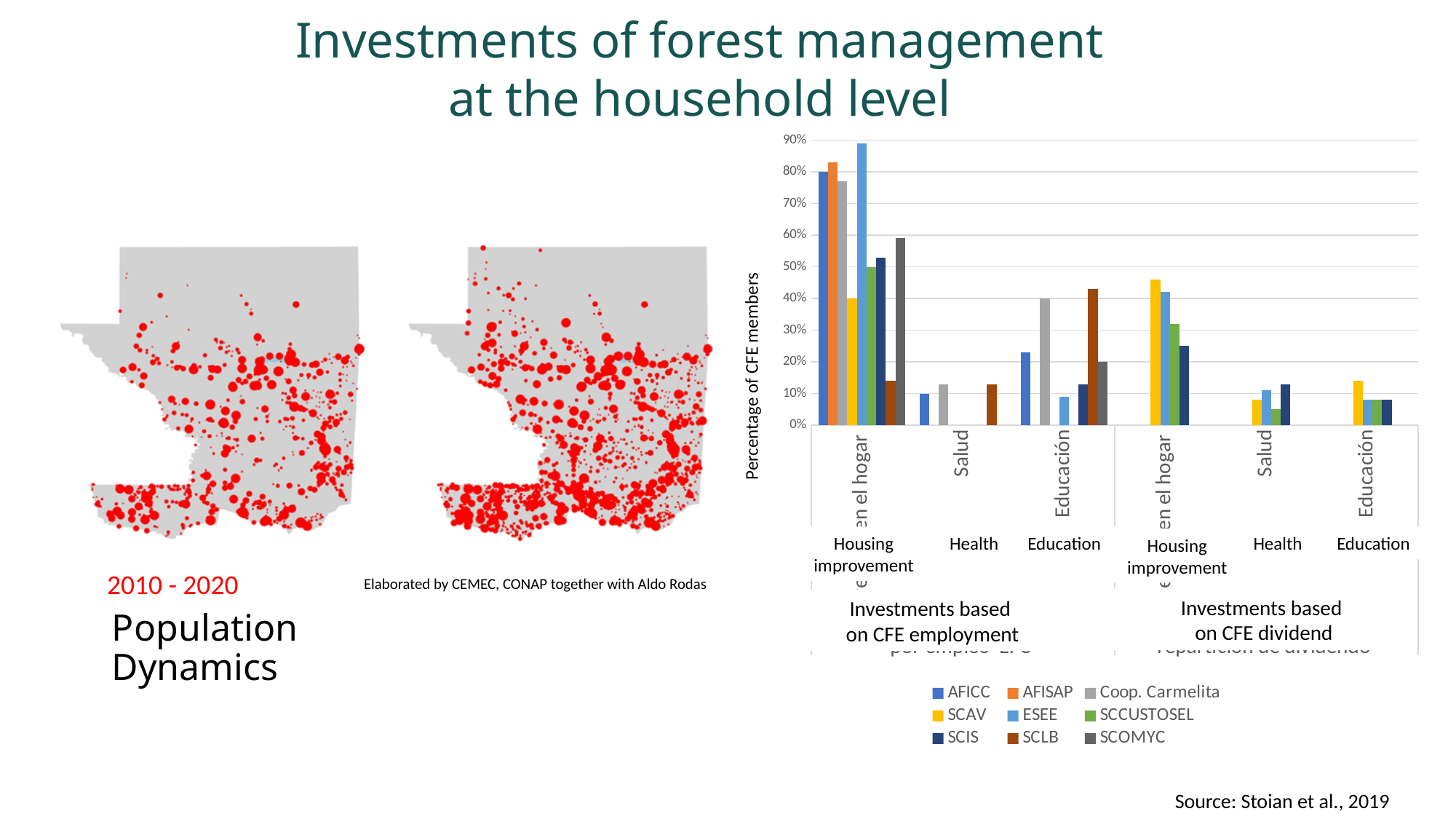
Which series has the highest value for Housing improvement under Investments based on CFE dividend? SCAV Which series has the lowest value for Housing improvement under Investments based on CFE employment? SCLB Under Investments based on CFE employment, which is larger for AFICC: Housing improvement or Education? Housing improvement Which series has the highest value for Housing improvement under Investments based on CFE employment? ESEE Is the value for SCLB in Education under Investments based on CFE employment greater or less than 40%? greater Is the value for SCAV in Housing improvement under Investments based on CFE employment greater or less than 50%? less What kind of chart is shown on the right side of the slide? bar chart What is the label of the vertical axis of the bar chart? Percentage of CFE members How many series does the legend of the bar chart list? 9 Is the value for ESEE in Housing improvement under Investments based on CFE employment greater or less than 80%? greater What is the highest value shown on the vertical axis of the bar chart? 90%